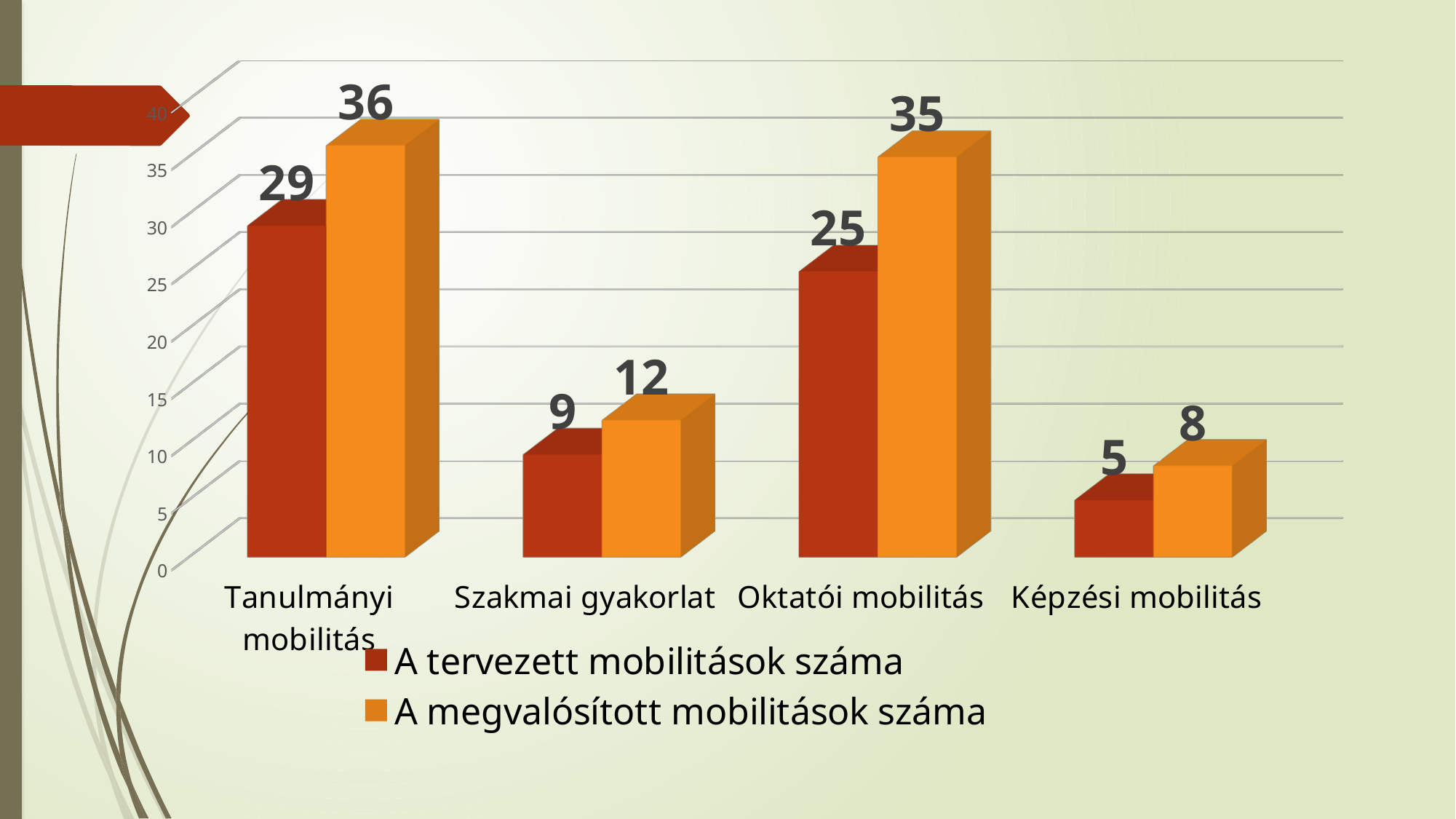
What is the value of 'A tervezett mobilitások száma' for Tanulmányi mobilitás? 29 How many categories are shown on the x axis? 4 Which category has the highest value for 'A megvalósított mobilitások száma'? Tanulmányi mobilitás What is the difference between 'A megvalósított mobilitások száma' and 'A tervezett mobilitások száma' for Oktatói mobilitás? 10 Which is larger for Tanulmányi mobilitás: 'A tervezett mobilitások száma' or 'A megvalósított mobilitások száma'? A megvalósított mobilitások száma What is the difference between 'A megvalósított mobilitások száma' and 'A tervezett mobilitások száma' for Szakmai gyakorlat? 3 What colour are the bars for 'A megvalósított mobilitások száma'? Orange What is the value of 'A megvalósított mobilitások száma' for Oktatói mobilitás? 35 Which category has the lowest value for 'A tervezett mobilitások száma'? Képzési mobilitás How many series does the legend list? 2 What kind of chart is shown on the slide? Bar chart What is the value of 'A megvalósított mobilitások száma' for Képzési mobilitás? 8